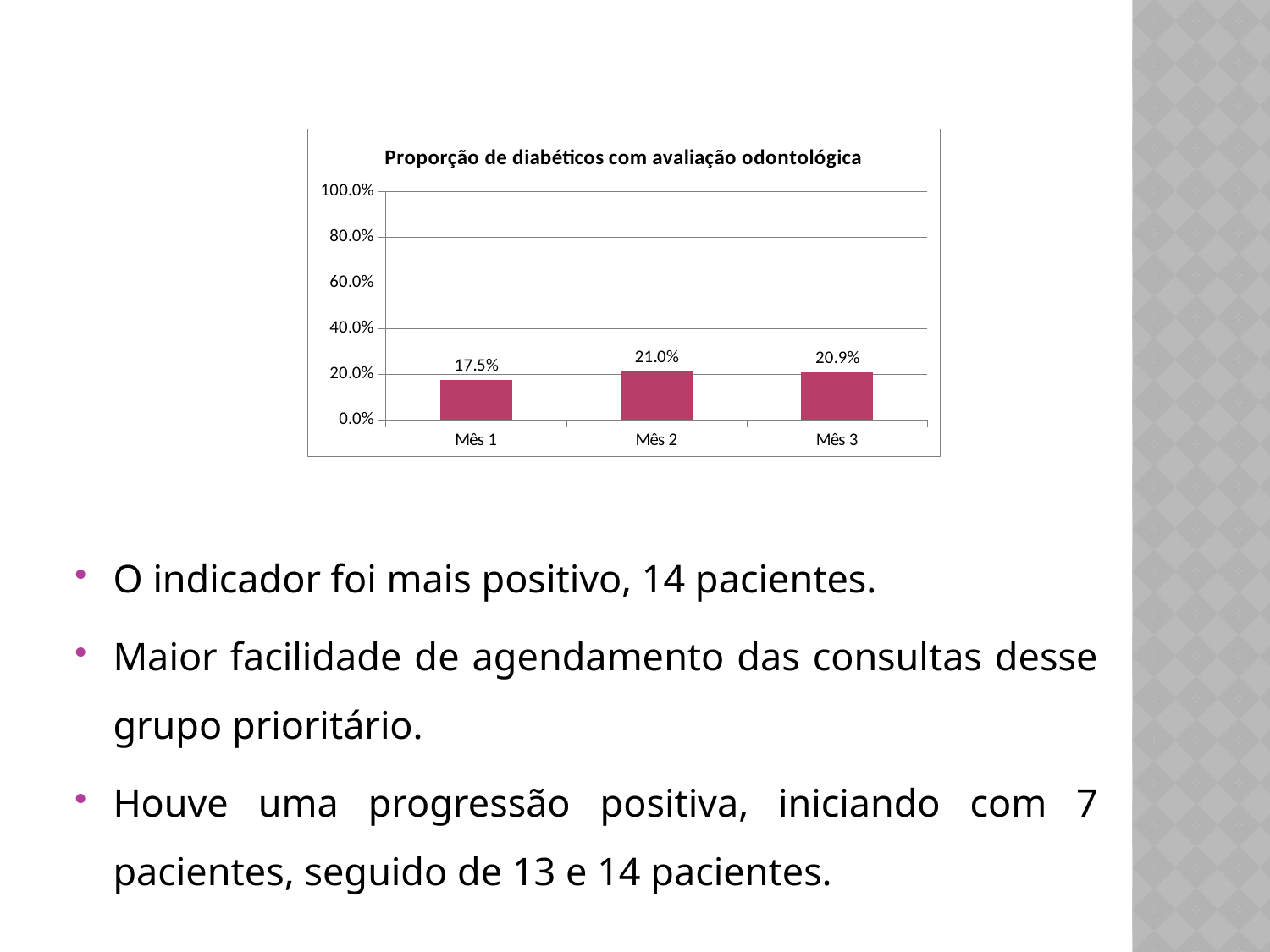
What is the value for Mês 2? 21.0% What is the difference between the values for Mês 2 and Mês 1? 3.5% What kind of chart is shown on the slide? bar chart What is the value for Mês 1? 17.5% What is the difference between the values for Mês 3 and Mês 1? 3.4% What is the value for Mês 3? 20.9% Which is larger, the value for Mês 1 or the value for Mês 3? Mês 3 What is the title of the chart? Proporção de diabéticos com avaliação odontológica How many months are shown on the x axis? 3 Which month has the highest proportion? Mês 2 Is the value for Mês 1 greater or less than 20.0%? less Which month has the lowest proportion? Mês 1